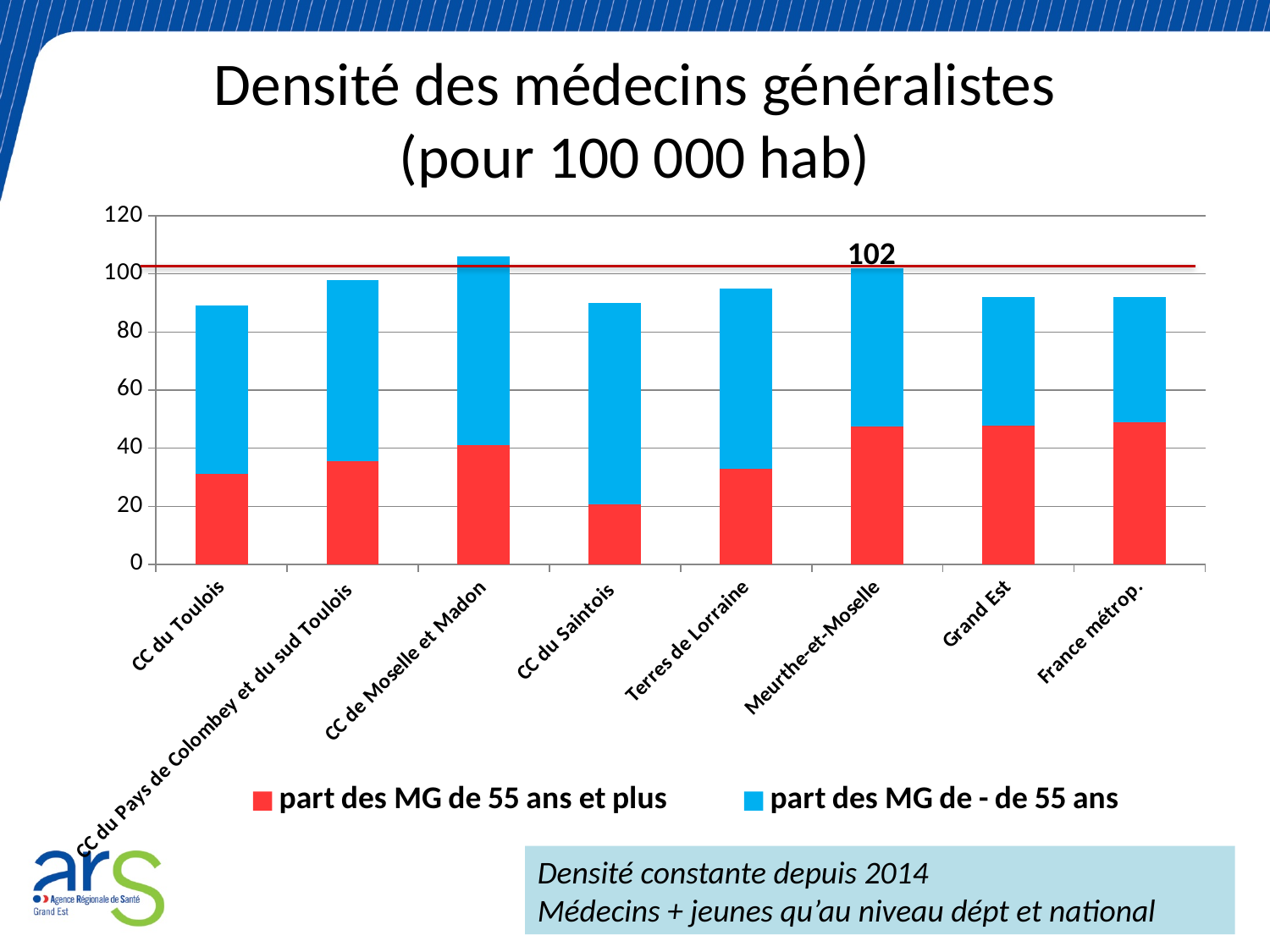
How many series does the legend list? 2 Is the total bar for CC de Moselle et Madon greater or less than 100? greater What is the title of the chart? Densité des médecins généralistes (pour 100 000 hab) What kind of chart is shown on the slide? bar chart Which category has the highest total bar? CC de Moselle et Madon Which colour represents 'part des MG de 55 ans et plus' in the legend? red How many categories are shown on the x axis of the chart? 8 What total value is labelled on the bar for Meurthe-et-Moselle? 102 Which category has the smallest segment for 'part des MG de 55 ans et plus'? CC du Saintois Is the total bar for CC du Toulois greater or less than 100? less Which has a larger 'part des MG de 55 ans et plus' segment: CC du Toulois or CC du Saintois? CC du Toulois Is the 'part des MG de 55 ans et plus' segment for CC du Saintois greater or less than 40? less